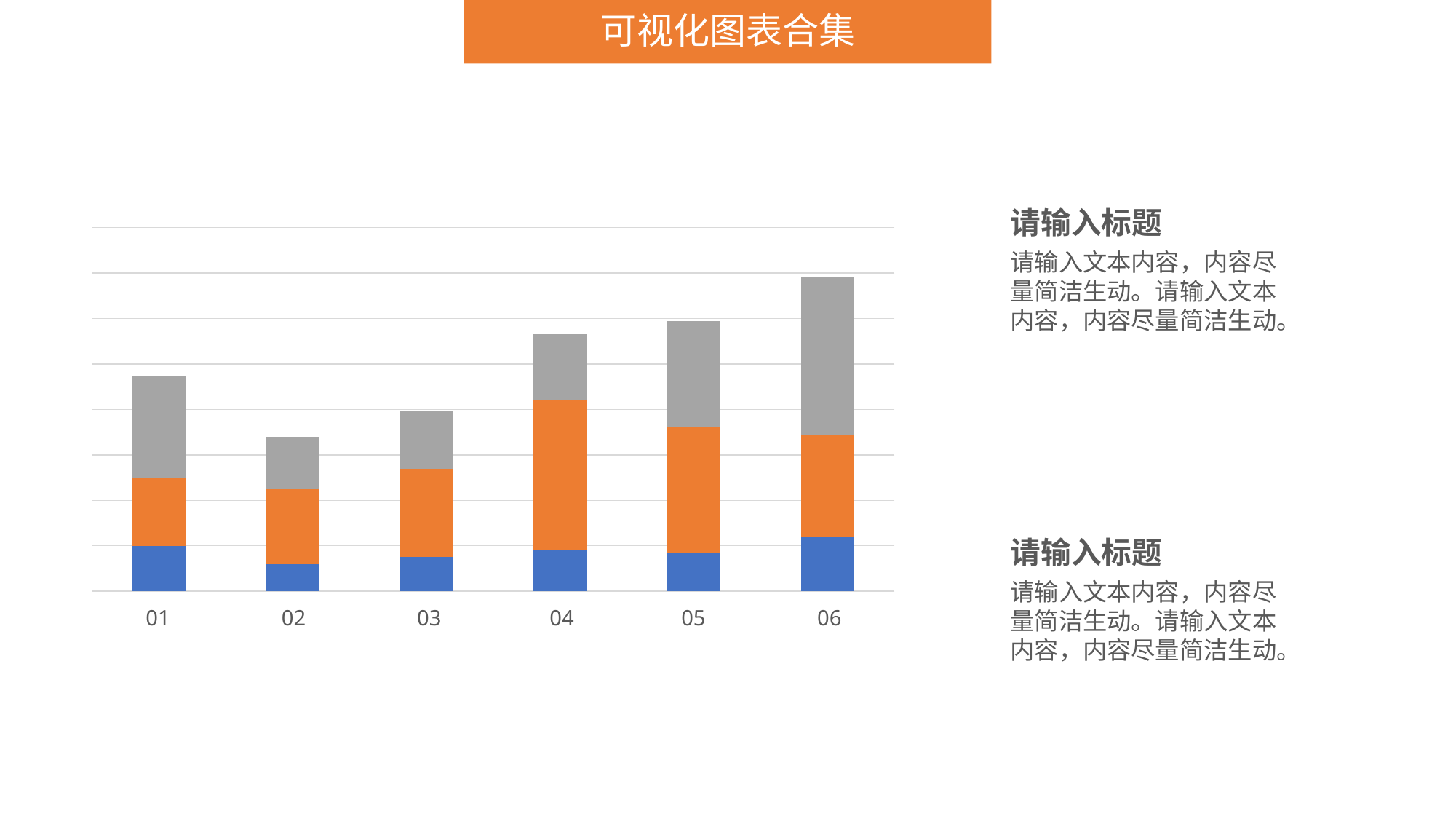
Which stacked bar is taller, 01 or 02? 01 Which category has the smallest blue (bottom) segment? 02 Which category has the largest blue (bottom) segment? 06 From category 02 to category 06, do the total bar heights rise or fall? Rise Which category has the largest gray (top) segment? 06 Which category has the tallest stacked bar overall? 06 What kind of chart is shown on the slide? Stacked bar chart Which category has the shortest stacked bar overall? 02 How many coloured segments make up each stacked bar? 3 Which stacked bar is taller, 03 or 04? 04 How many categories are shown on the x axis of the chart? 6